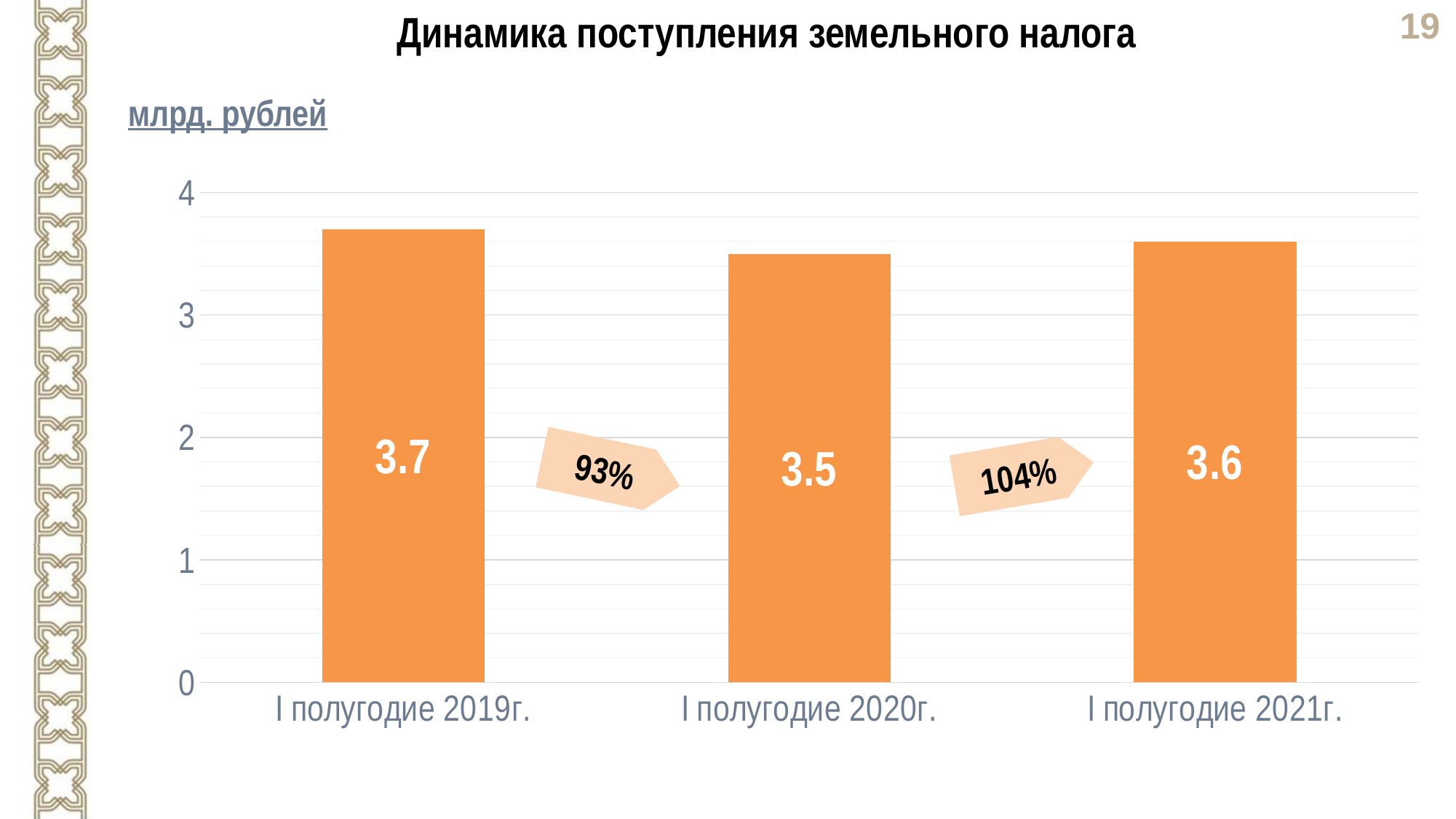
What is the value for I полугодие 2019г.? 3.7 Is the value for I полугодие 2020г. greater or less than 3? greater How many periods are shown on the chart? 3 Which is larger, the value for I полугодие 2019г. or I полугодие 2021г.? I полугодие 2019г. What is the value for I полугодие 2021г.? 3.6 What is the value for I полугодие 2020г.? 3.5 Which period has the lowest value? I полугодие 2020г. What is the difference between the values for I полугодие 2021г. and I полугодие 2020г.? 0.1 What is the difference between the values for I полугодие 2019г. and I полугодие 2020г.? 0.2 What is the title of the chart? Динамика поступления земельного налога What kind of chart is shown on the slide? bar chart Which period has the highest value? I полугодие 2019г.